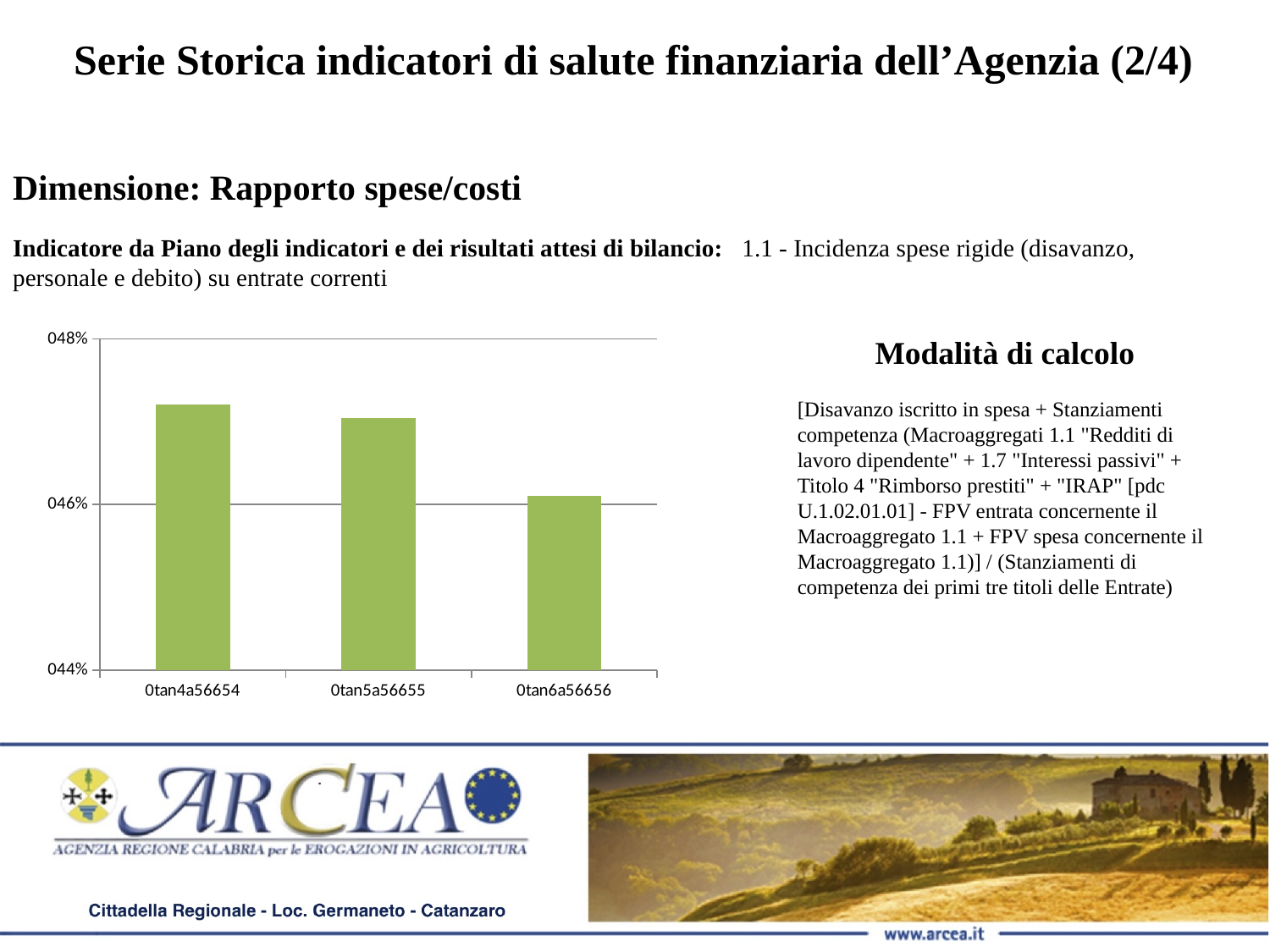
Which is larger, the value for 0tan5a56655 or the value for 0tan6a56656? 0tan5a56655 Which is larger, the value for 0tan4a56654 or the value for 0tan6a56656? 0tan4a56654 Is the value for 0tan5a56655 greater or less than 048%? less Is the value for 0tan4a56654 greater or less than 046%? greater What kind of chart is shown on the slide? bar chart What is the label of the first category on the x axis? 0tan4a56654 What colour are the bars in the chart? green Which category has the lowest value in the chart? 0tan6a56656 How many bars does the chart show? 3 Do the values rise or fall from left to right along the x axis? fall Is the value for 0tan6a56656 greater or less than 048%? less